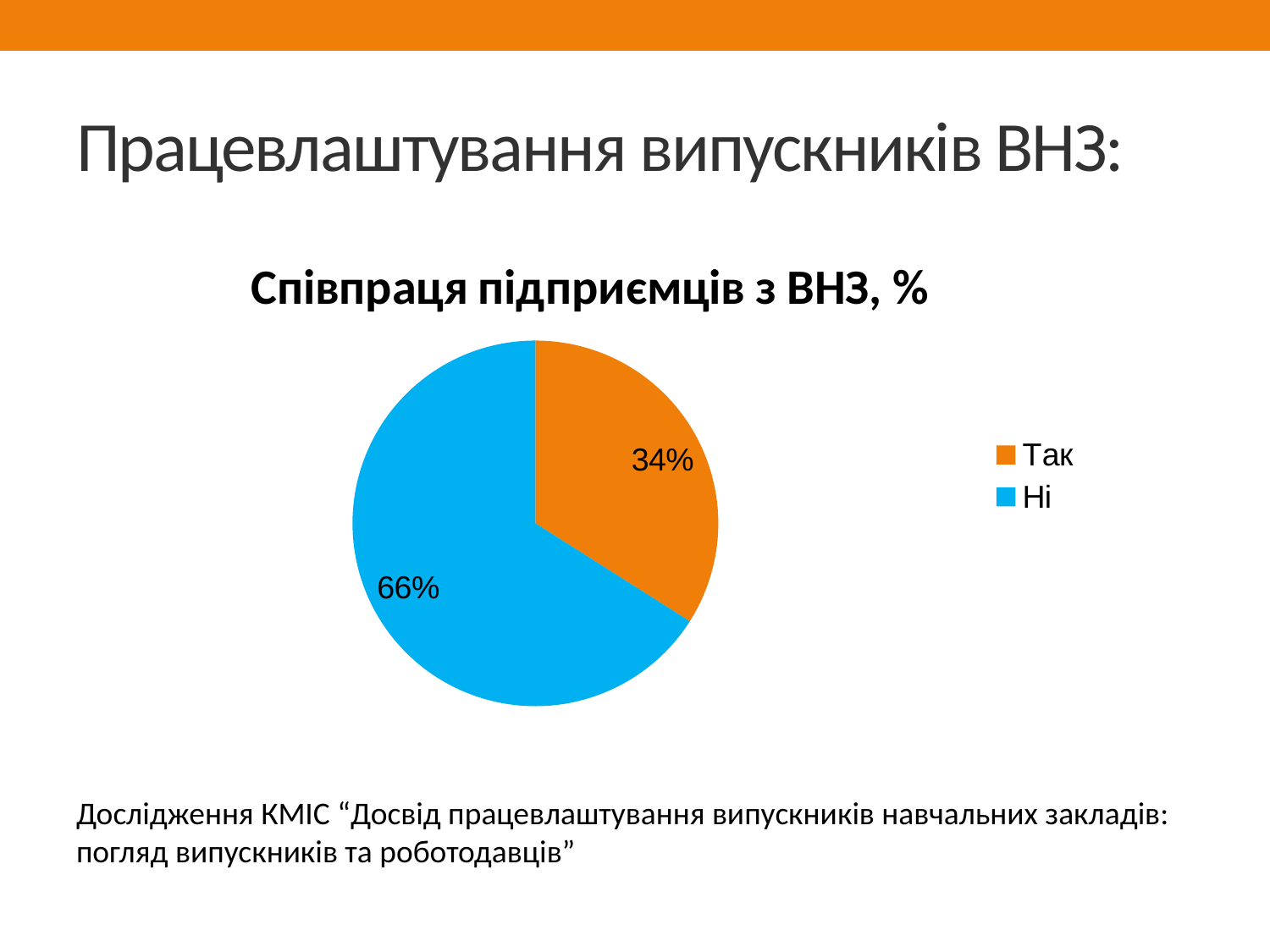
Which slice of the pie chart is the largest? Ні What is the value for "Так" in the pie chart? 34% What share of the pie does the "Так" slice represent? 34% What is the difference between the "Ні" and "Так" slices? 32% Which is larger, the "Так" slice or the "Ні" slice? Ні What is the value for "Ні" in the pie chart? 66% How many entries does the legend list? 2 Which slice of the pie chart is the smallest? Так How many slices does the pie chart have? 2 What colour is the "Ні" slice in the pie chart? blue What kind of chart is shown on the slide? pie chart What is the title of the chart? Співпраця підприємців з ВНЗ, %